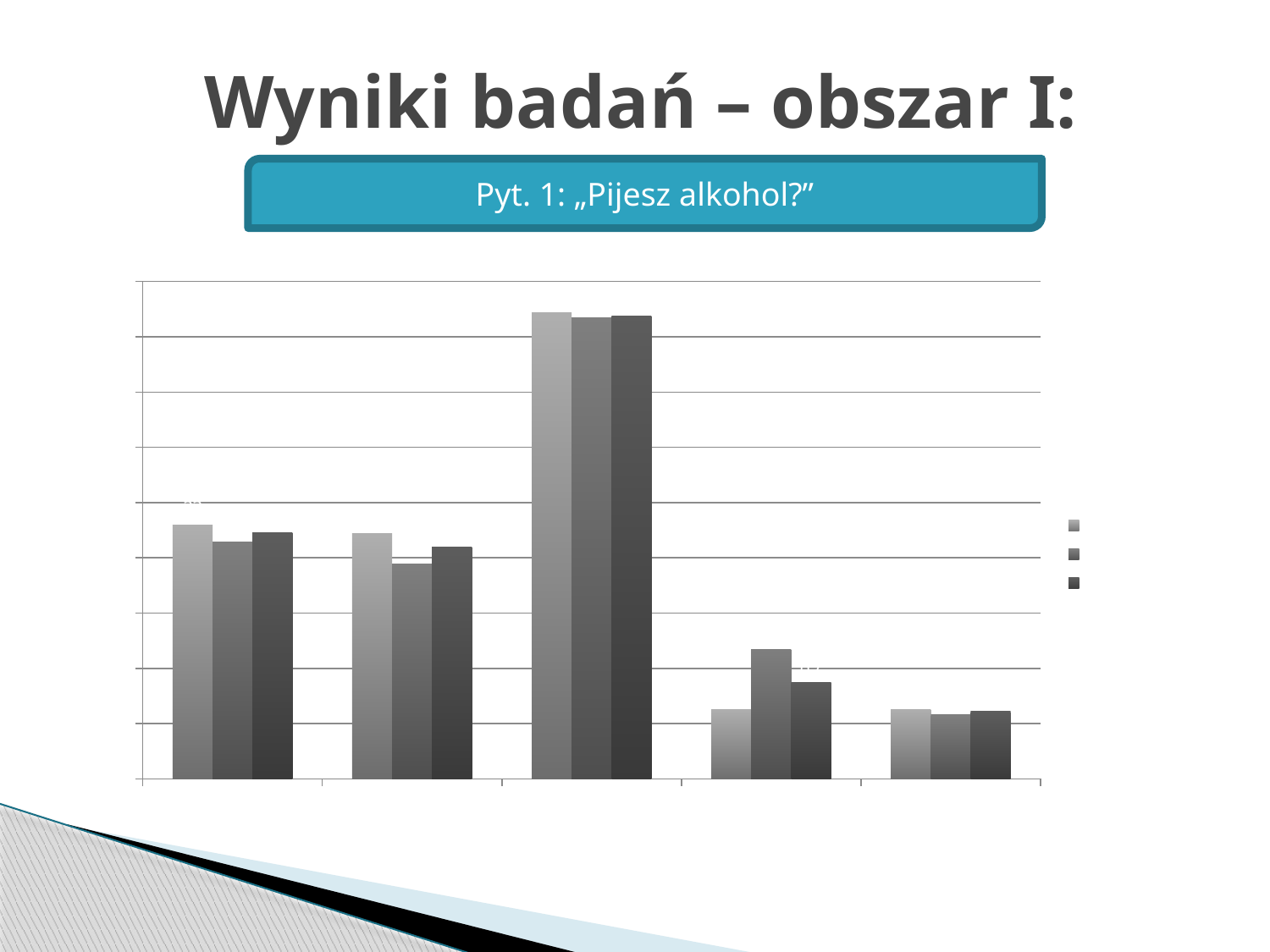
Which group of bars, counted from the left, has the tallest bars? the third group Which group of bars, counted from the left, has the shortest bars? the fifth group Are the bars in the third group from the left taller or shorter than the bars in the first group? taller How many bars are in each group on the chart? 3 Are the bars on the chart vertical or horizontal? vertical Are the bars in the fourth group from the left taller or shorter than the bars in the second group? shorter What kind of chart is shown on the slide? bar chart How many groups of bars (categories) does the chart show? 5 How many series does the legend list? 3 What survey question is the chart on the slide about? Pyt. 1: „Pijesz alkohol?”